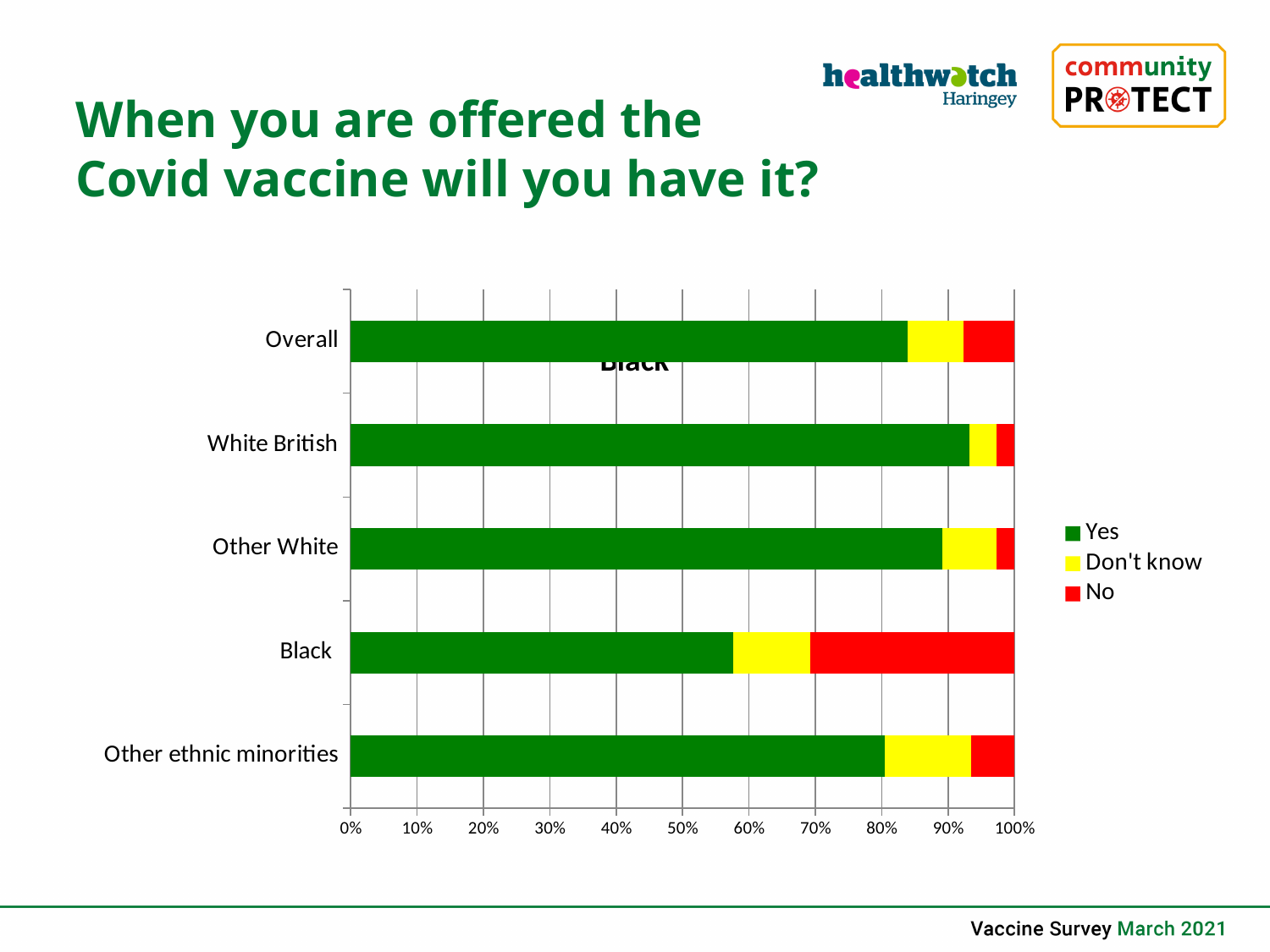
What is the total of the stacked bar for Black? 100% Which group has the largest 'Yes' share? White British Which colour represents the 'No' series in the legend? Red Is the 'Yes' value for Overall greater or less than 80%? greater How many categories (groups) are shown on the chart? 5 Which is larger: the 'Yes' share for Other White or the 'Yes' share for Other ethnic minorities? Other White Is the 'Yes' value for White British greater or less than 90%? greater Which group has the smallest 'Yes' share? Black Which group has the largest 'No' share? Black Is the 'Yes' value for Black greater or less than 60%? less What kind of chart is shown on the slide? Stacked bar chart How many series does the legend list? 3